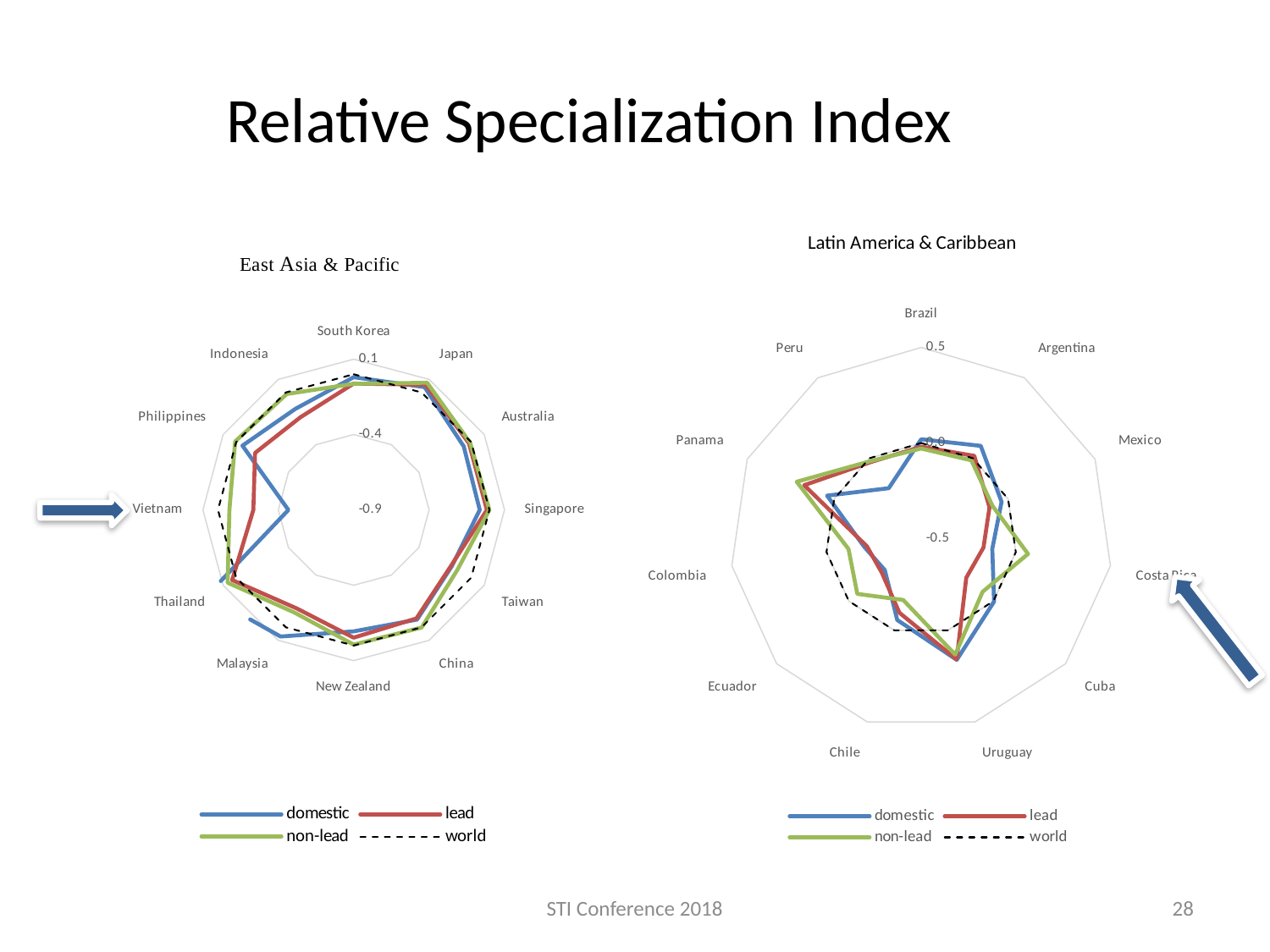
On the East Asia & Pacific chart, is the domestic value for Singapore greater or less than -0.4? greater On the Latin America & Caribbean chart, which is larger for Panama: the domestic value or the non-lead value? non-lead On the Latin America & Caribbean chart, is the non-lead value for Colombia greater or less than 0.0? less How many series does the legend of the Latin America & Caribbean chart list? 4 How many series does the legend of the East Asia & Pacific chart list? 4 Which series is drawn with a dashed line on the Latin America & Caribbean chart? world How many countries are plotted on the East Asia & Pacific chart? 12 On the East Asia & Pacific chart, is the non-lead value for Vietnam greater or less than -0.4? greater How many countries are plotted on the Latin America & Caribbean chart? 11 What is the title of the chart on the left of the slide? East Asia & Pacific What kind of chart is the East Asia & Pacific chart? radar chart On the East Asia & Pacific chart, which is larger for Vietnam: the domestic value or the non-lead value? non-lead